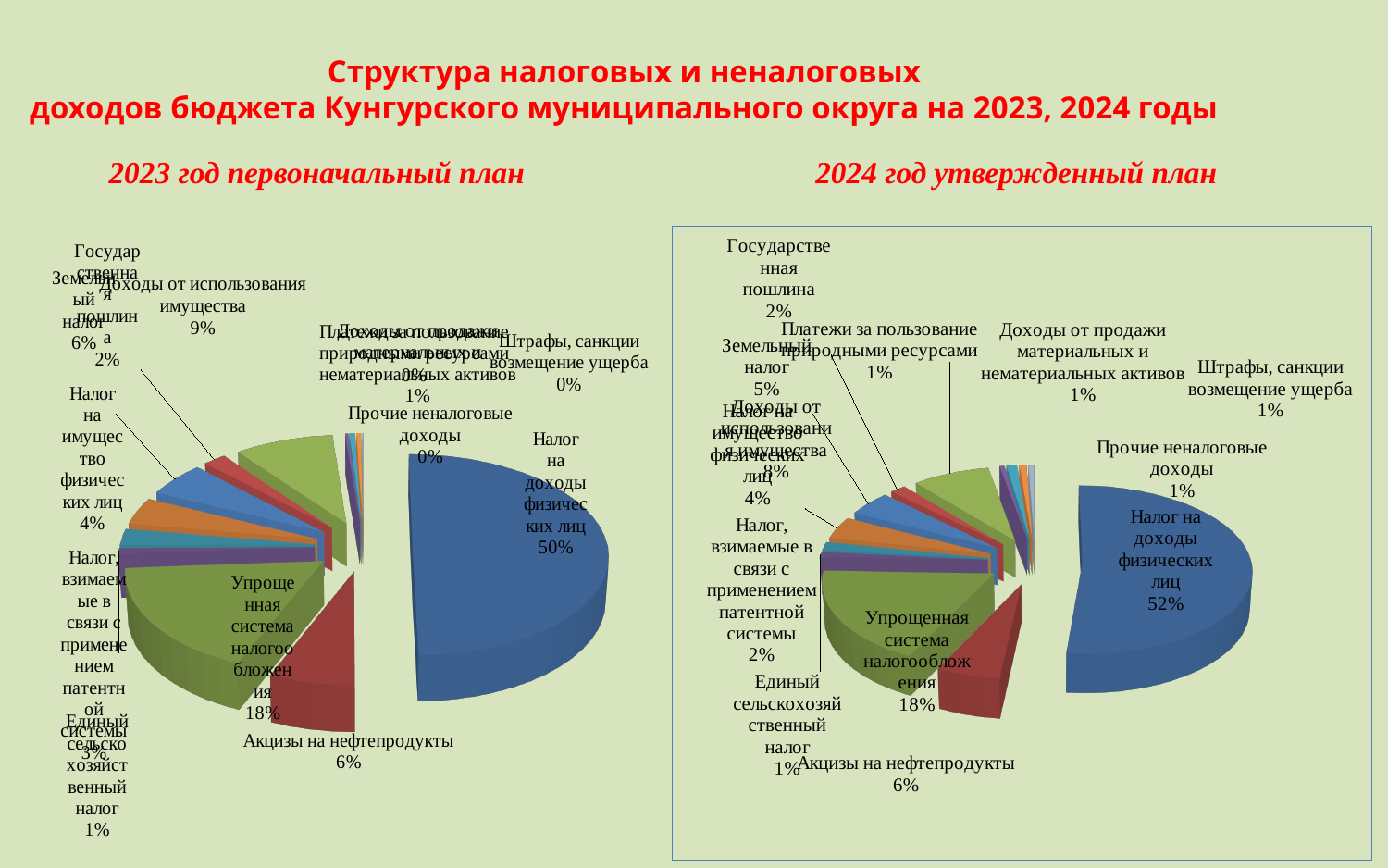
What type of charts are shown on the slide? Pie charts In the 2024 год утвержденный план chart, which category has the largest share? Налог на доходы физических лиц What is the difference between the share of Налог на доходы физических лиц in the 2024 chart and in the 2023 chart? 2% In the 2024 год утвержденный план chart, what share is Упрощенная система налогообложения? 18% How many categories are labelled in the 2024 год утвержденный план chart? 13 In the 2023 год первоначальный план chart, what share is Акцизы на нефтепродукты? 6% In the 2024 год утвержденный план chart, what share is Налог на доходы физических лиц? 52% In the 2023 год первоначальный план chart, which category has the largest share? Налог на доходы физических лиц In the 2024 год утвержденный план chart, which is larger: Акцизы на нефтепродукты or Доходы от использования имущества? Доходы от использования имущества